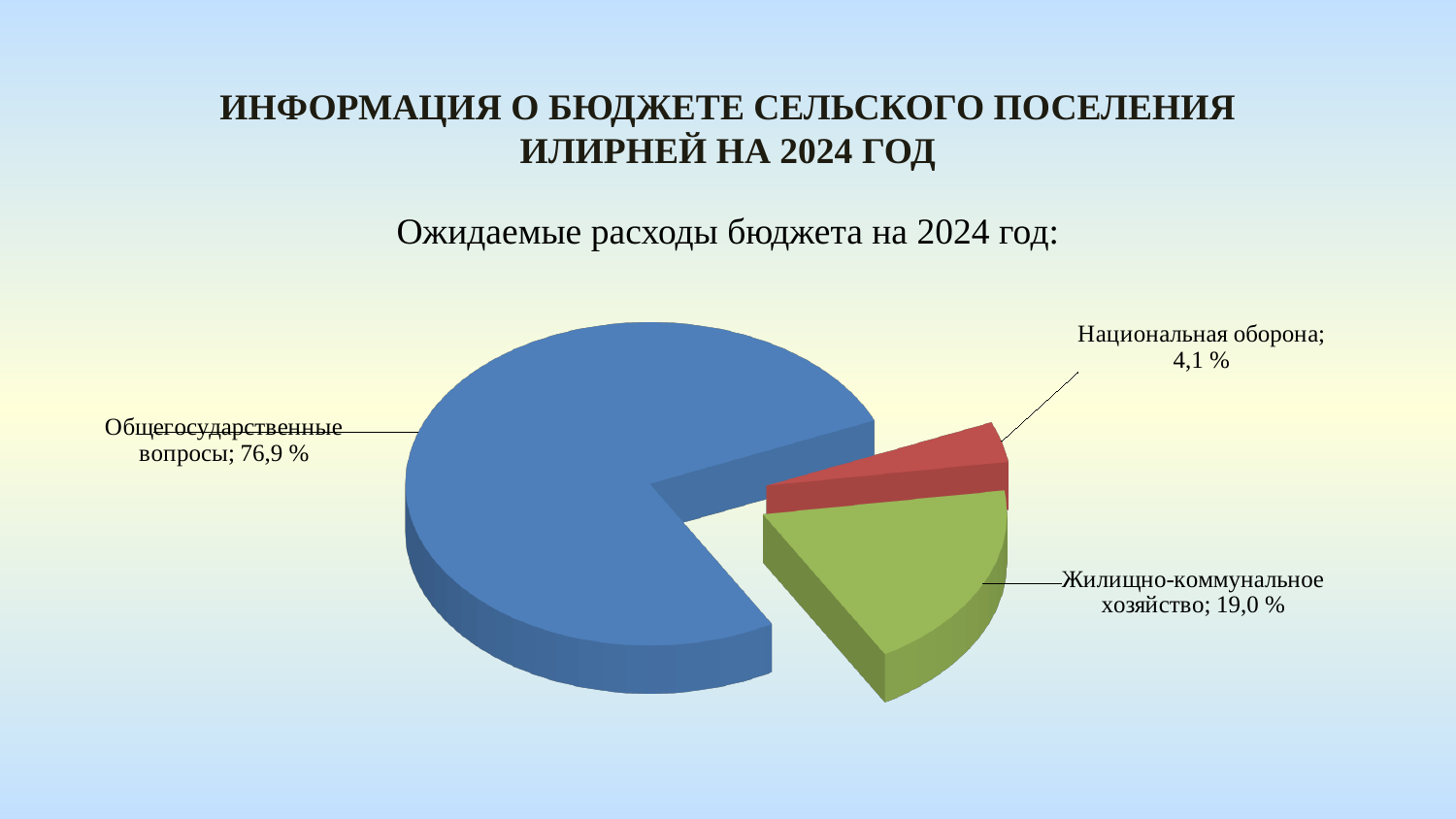
What is the difference in percentage points between the shares of Жилищно-коммунальное хозяйство and Национальная оборона? 14,9 What kind of chart is shown on the slide? Pie chart What share of the expected 2024 budget expenditures goes to Национальная оборона? 4,1 % What share of the expected 2024 budget expenditures goes to Жилищно-коммунальное хозяйство? 19,0 % Which is larger: the share for Жилищно-коммунальное хозяйство or the share for Национальная оборона? Жилищно-коммунальное хозяйство How many categories are shown in the pie chart? 3 What colour is the slice for Общегосударственные вопросы? Blue Which expenditure category has the smallest share of the pie? Национальная оборона What is the subtitle above the chart? Ожидаемые расходы бюджета на 2024 год: What is the difference in percentage points between the shares of Общегосударственные вопросы and Жилищно-коммунальное хозяйство? 57,9 What share of the expected 2024 budget expenditures goes to Общегосударственные вопросы? 76,9 % Which expenditure category has the largest share of the pie? Общегосударственные вопросы